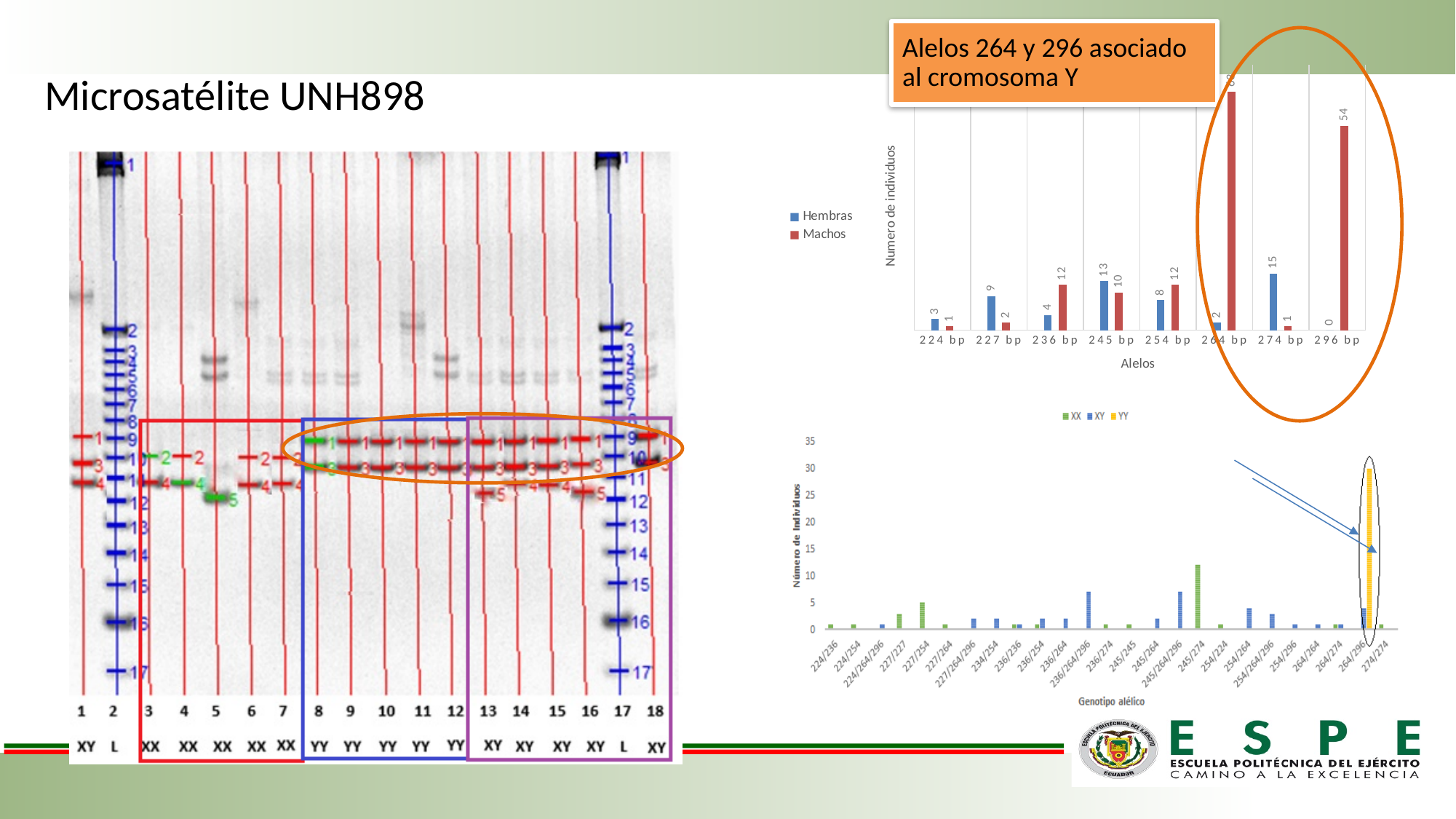
In the top-right chart (Hembras/Machos by allele), what is the value for Hembras at 296 bp? 0 What kind of chart is the bottom-right chart (Genotipo alélico)? bar chart In the top-right chart (Hembras/Machos by allele), which is larger at 236 bp, Hembras or Machos? Machos In the bottom-right chart (Genotipo alélico), is the value for 274/274 greater or less than 25? less In the top-right chart (Hembras/Machos by allele), which allele has the highest Hembras value? 274 bp In the top-right chart (Hembras/Machos by allele), how many series does the legend list? 2 In the top-right chart (Hembras/Machos by allele), which allele has the highest Machos value? 264 bp In the bottom-right chart (Genotipo alélico), how many series does the legend list? 3 In the top-right chart (Hembras/Machos by allele), what is the difference between Hembras and Machos at 274 bp? 14 In the top-right chart (Hembras/Machos by allele), what is the value for Machos at 296 bp? 54 In the top-right chart (Hembras/Machos by allele), what is the value for Hembras at 245 bp? 13 In the top-right chart (Hembras/Machos by allele), how many alleles are shown on the x axis? 8